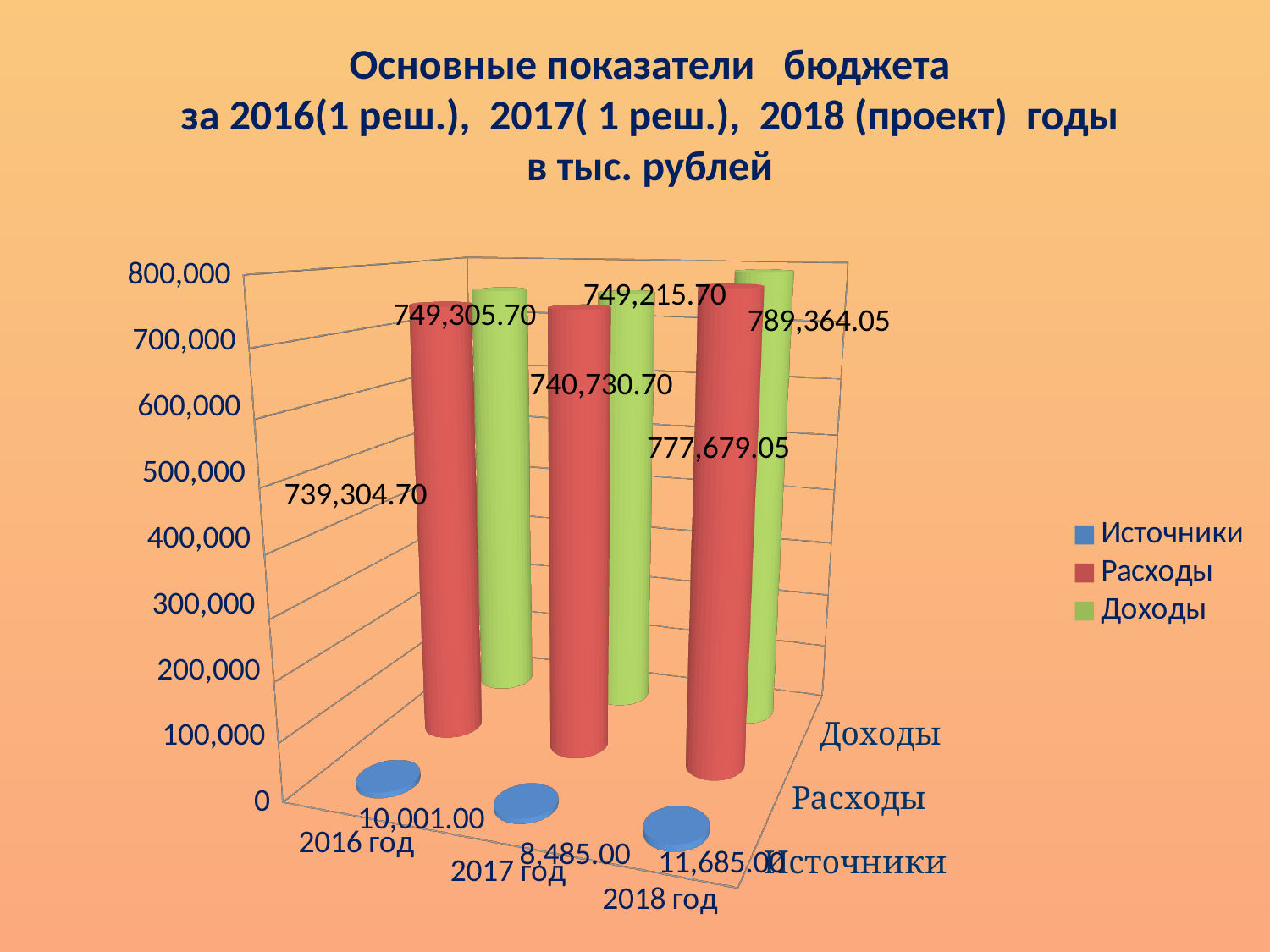
What is the value of Источники for 2017 год? 8,485.00 In which year is Доходы highest? 2018 год For 2017 год, which is larger: Расходы or Доходы? Доходы What is the difference between Доходы and Расходы for 2018 год? 11,685.00 How many years are shown on the x axis? 3 Do the Расходы values rise or fall from 2016 год to 2018 год? rise How many series does the legend list? 3 In which year is Расходы lowest? 2016 год What is the value of Расходы for 2016 год? 739,304.70 What is the value of Доходы for 2018 год? 789,364.05 What kind of chart is shown on the slide? bar chart Which colour represents Доходы in the legend? green